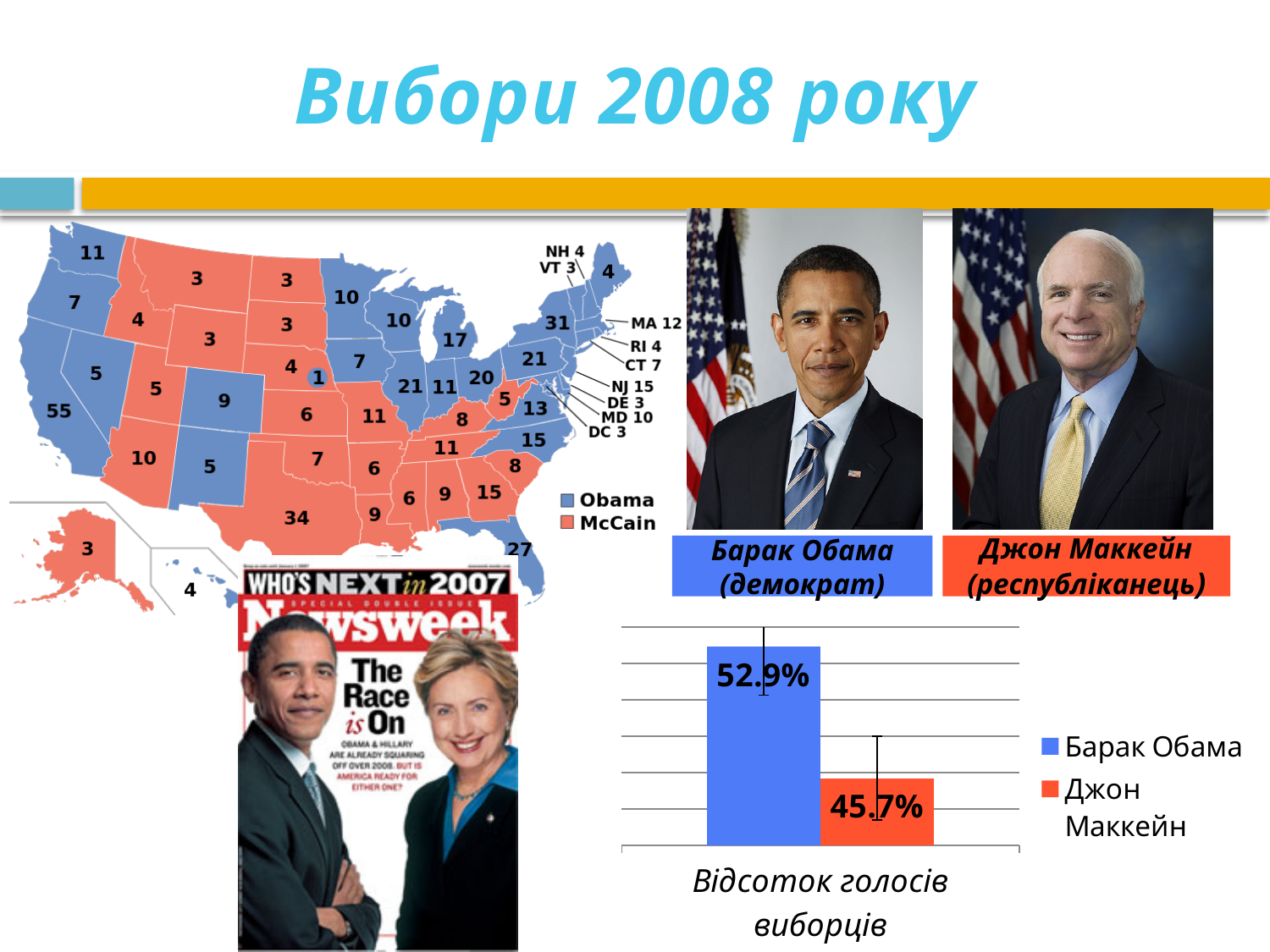
What colour is the bar for Джон Маккейн in the chart? orange-red What percentage of the vote does the bar chart show for Джон Маккейн? 45.7% Which candidate has the lower bar in the chart? Джон Маккейн Is the value for Барак Обама larger or smaller than the value for Джон Маккейн in the bar chart? larger How many bars are plotted in the chart? 2 What percentage of the vote does the bar chart show for Барак Обама? 52.9% What is the category label shown under the bars of the chart? Відсоток голосів виборців How many series does the legend of the bar chart list? 2 What is the difference between Барак Обама's and Джон Маккейн's percentages in the bar chart? 7.2% Which candidate has the higher bar in the chart? Барак Обама What kind of chart is shown at the bottom right of the slide? bar chart